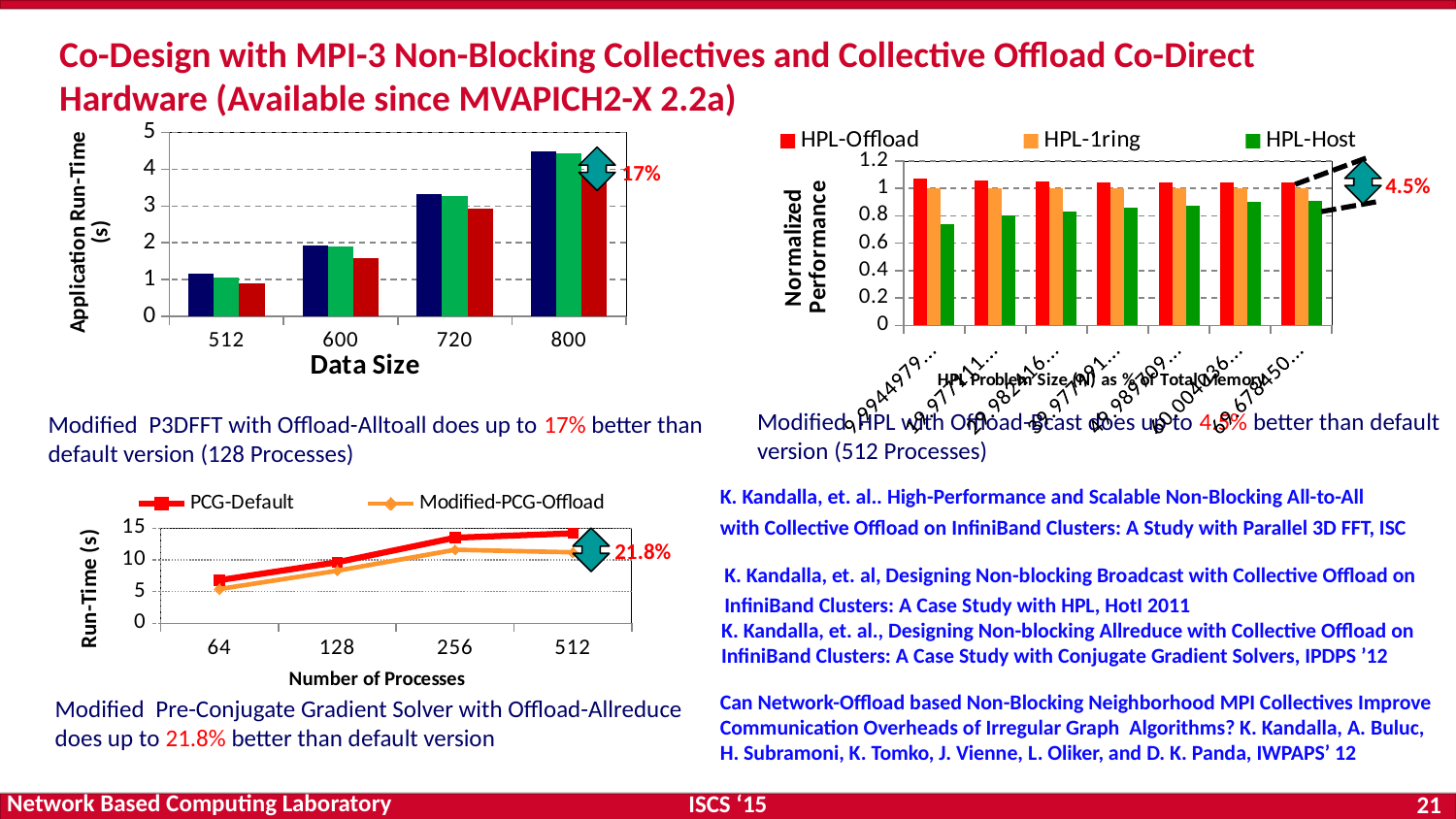
In the bottom-left chart, at 512 processes, which series has the higher run-time: PCG-Default or Modified-PCG-Offload? PCG-Default In the top-right chart, which series has the lowest normalized performance in each group: HPL-Offload, HPL-1ring or HPL-Host? HPL-Host How many data size categories are shown on the x-axis of the top-left chart? 4 In the top-left chart, which data size has the lowest application run-time? 512 What kind of chart is the top-left chart with the x-axis 'Data Size'? bar chart In the top-left chart, which data size has the highest application run-time? 800 In the top-left chart, does the application run-time rise or fall as the data size increases along the x-axis? rise How many series does the legend of the top-right chart (Normalized Performance) list? 3 What are the legend entries of the top-right chart? HPL-Offload, HPL-1ring, HPL-Host What kind of chart is the bottom-left chart with the x-axis 'Number of Processes'? line chart How many series does the legend of the bottom-left chart (Run-Time vs Number of Processes) list? 2 In the top-left chart, are the run-time values for data size 512 greater or less than 2? less